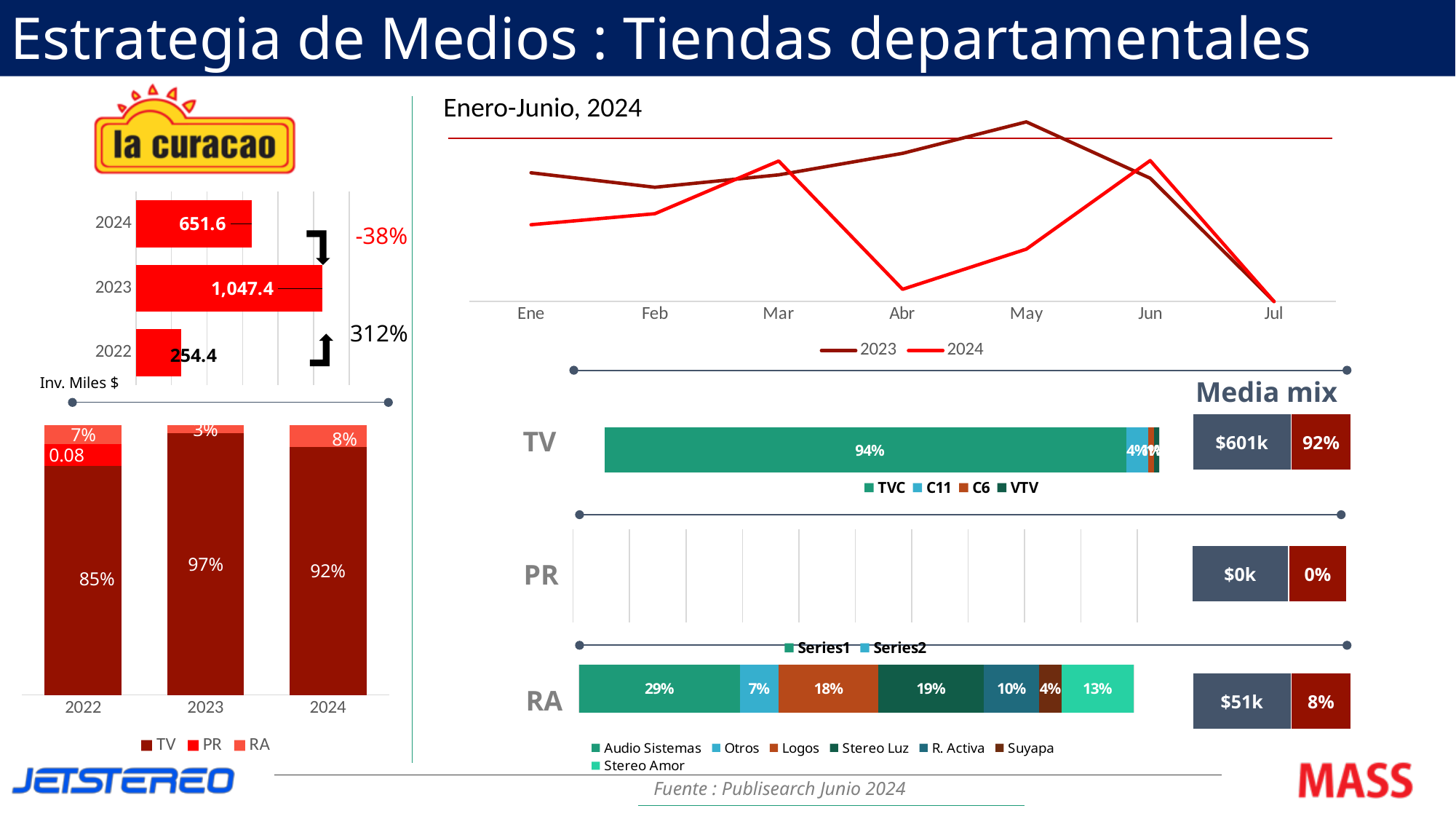
In the RA stacked bar on the right, which station has the largest share? Audio Sistemas In the investment bar chart on the left (Inv. Miles $), what is the value for 2023? 1,047.4 In the stacked bar chart at the bottom left, what share does TV have in 2023? 97% In the line chart titled Enero-Junio, 2024, how many months are shown on the x axis? 7 In the TV stacked bar on the right, what share does TVC have? 94% In the investment bar chart on the left (Inv. Miles $), which year has the lowest investment? 2022 In the Media mix boxes on the right, what is the dollar amount shown for RA? $51k In the investment bar chart on the left (Inv. Miles $), what is the difference between the 2023 and 2024 values? 395.8 In the investment bar chart on the left, what percentage change is shown between 2023 and 2024? -38% In the stacked bar chart at the bottom left, how many series does the legend list? 3 In the RA stacked bar on the right, what is the difference between the shares of Stereo Luz and Otros? 12% In the line chart titled Enero-Junio, 2024, in which month does the 2023 line reach its highest point? May